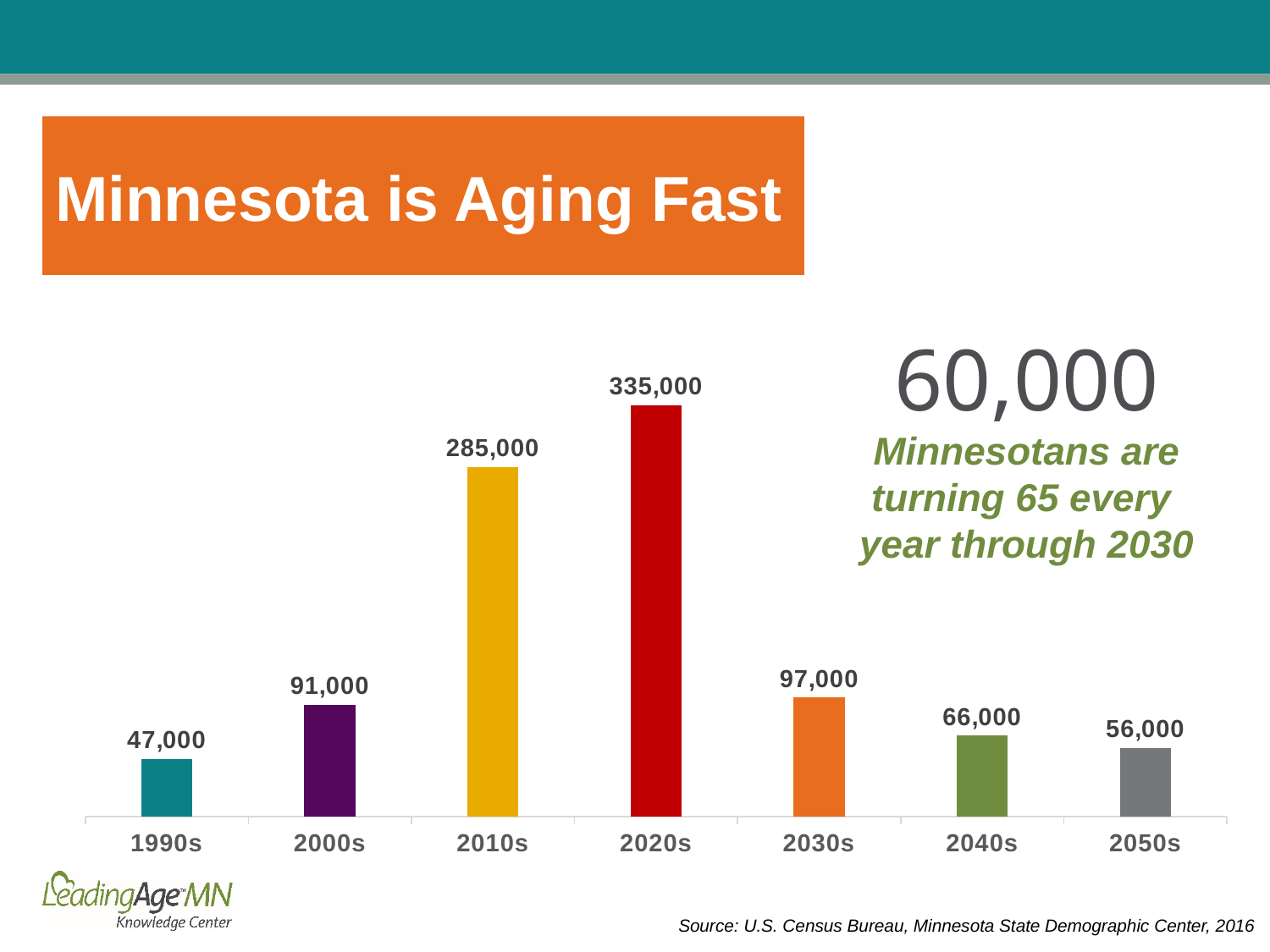
Which is larger, the value for the 2000s or the value for the 2030s? 2030s What kind of chart is shown on the slide? Bar chart What is the difference between the values for the 2020s and the 2010s? 50,000 What is the value for the 2020s? 335,000 How many decades are shown on the x axis? 7 Do the values rise or fall from the 2020s to the 2050s? Fall What is the title of the slide containing the chart? Minnesota is Aging Fast What is the value for the 2040s? 66,000 What is the value for the 1990s? 47,000 Which decade has the highest value? 2020s Which decade has the lowest value? 1990s What is the difference between the values for the 2030s and the 2050s? 41,000